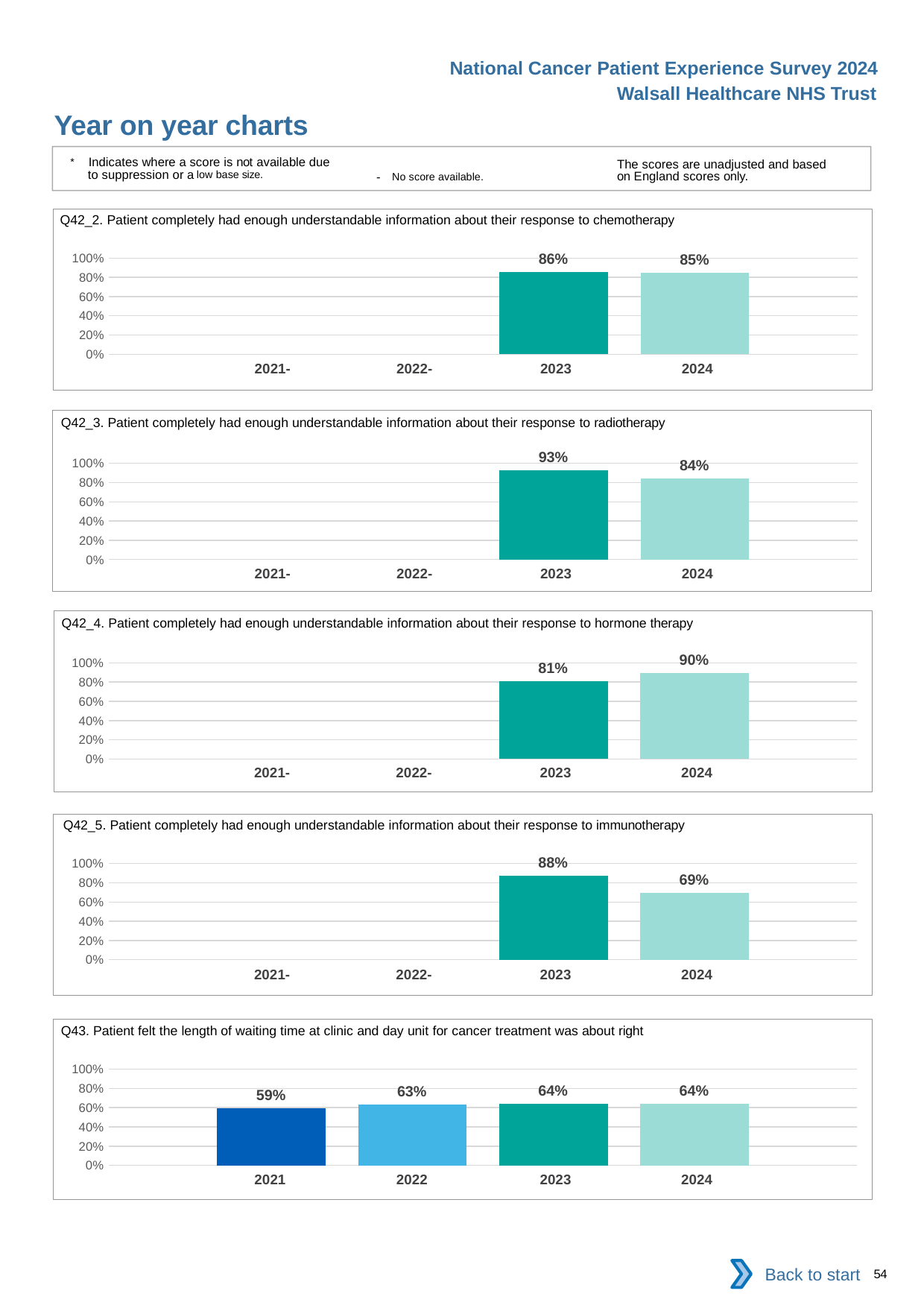
In the Q42_5 chart (immunotherapy), is the value for 2024 greater or less than 80%? less In the Q42_2 chart (chemotherapy), what is the value for 2023? 86% What kind of chart is the Q42_2 chart (chemotherapy)? bar chart In the Q43 chart (waiting time at clinic and day unit), which year has the lowest value? 2021 In the Q42_5 chart (immunotherapy), what is the difference between the 2023 and 2024 values? 19% In the Q43 chart (waiting time at clinic and day unit), what is the value for 2021? 59% In the Q42_3 chart (radiotherapy), what is the difference between the 2023 and 2024 values? 9% In the Q43 chart (waiting time at clinic and day unit), do the values rise or fall from 2021 to 2023? rise How many years have bars plotted in the Q43 chart (waiting time at clinic and day unit)? 4 In the Q42_3 chart (radiotherapy), what is the value for 2024? 84% In the Q42_4 chart (hormone therapy), which year has the higher value, 2023 or 2024? 2024 In the Q42_4 chart (hormone therapy), what is the value for 2023? 81%